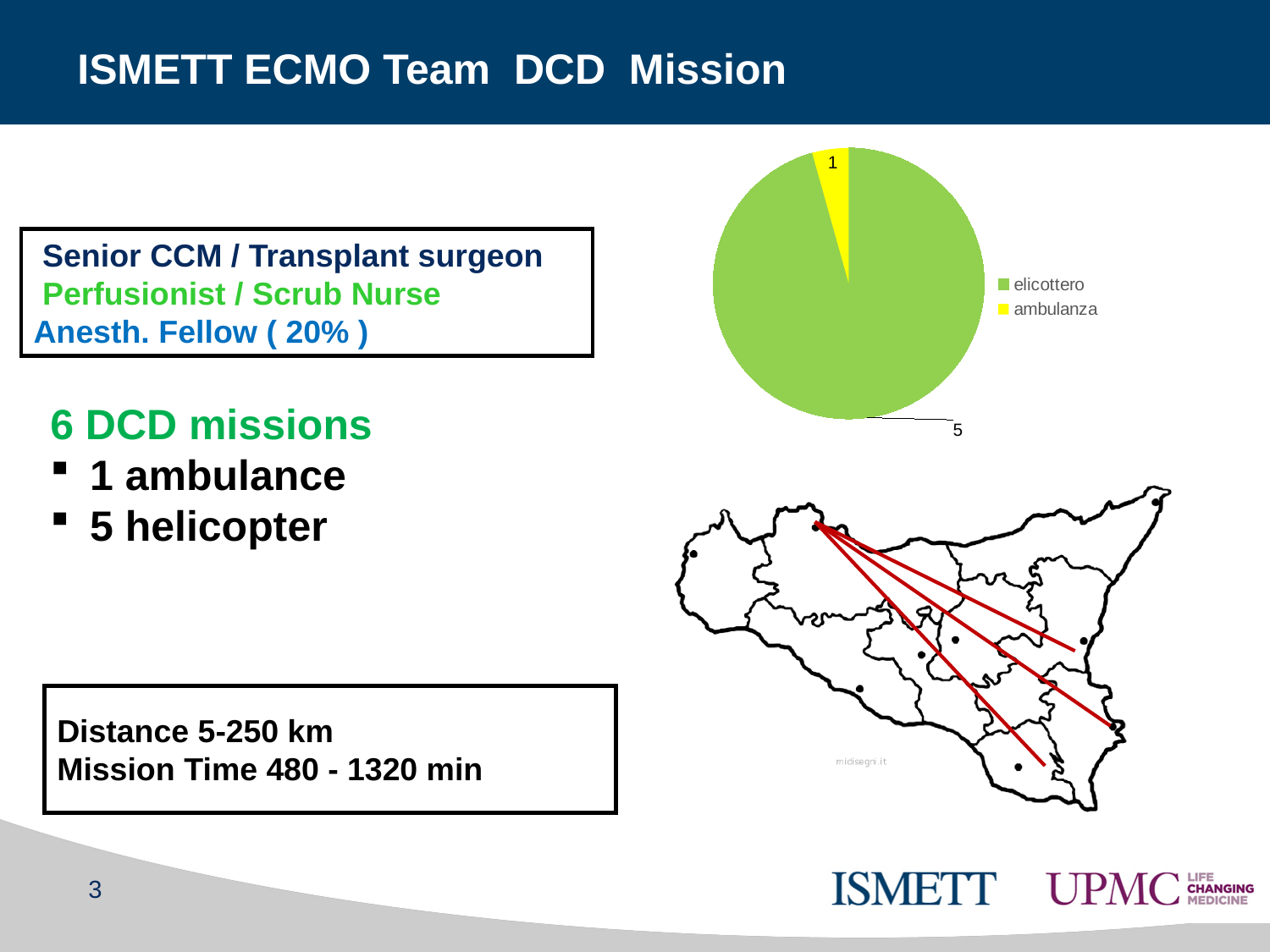
What is the value for ambulanza in the pie chart? 1 What colour is the ambulanza slice in the pie chart? yellow Which category has the smallest slice in the pie chart? ambulanza What kind of chart is shown on the slide? pie chart What is the total of the values shown in the pie chart? 6 What colour is the elicottero slice in the pie chart? green Which is larger in the pie chart, elicottero or ambulanza? elicottero What is the difference between the elicottero and ambulanza values in the pie chart? 4 What is the value for elicottero in the pie chart? 5 How many categories does the pie chart legend list? 2 Which category has the largest slice in the pie chart? elicottero